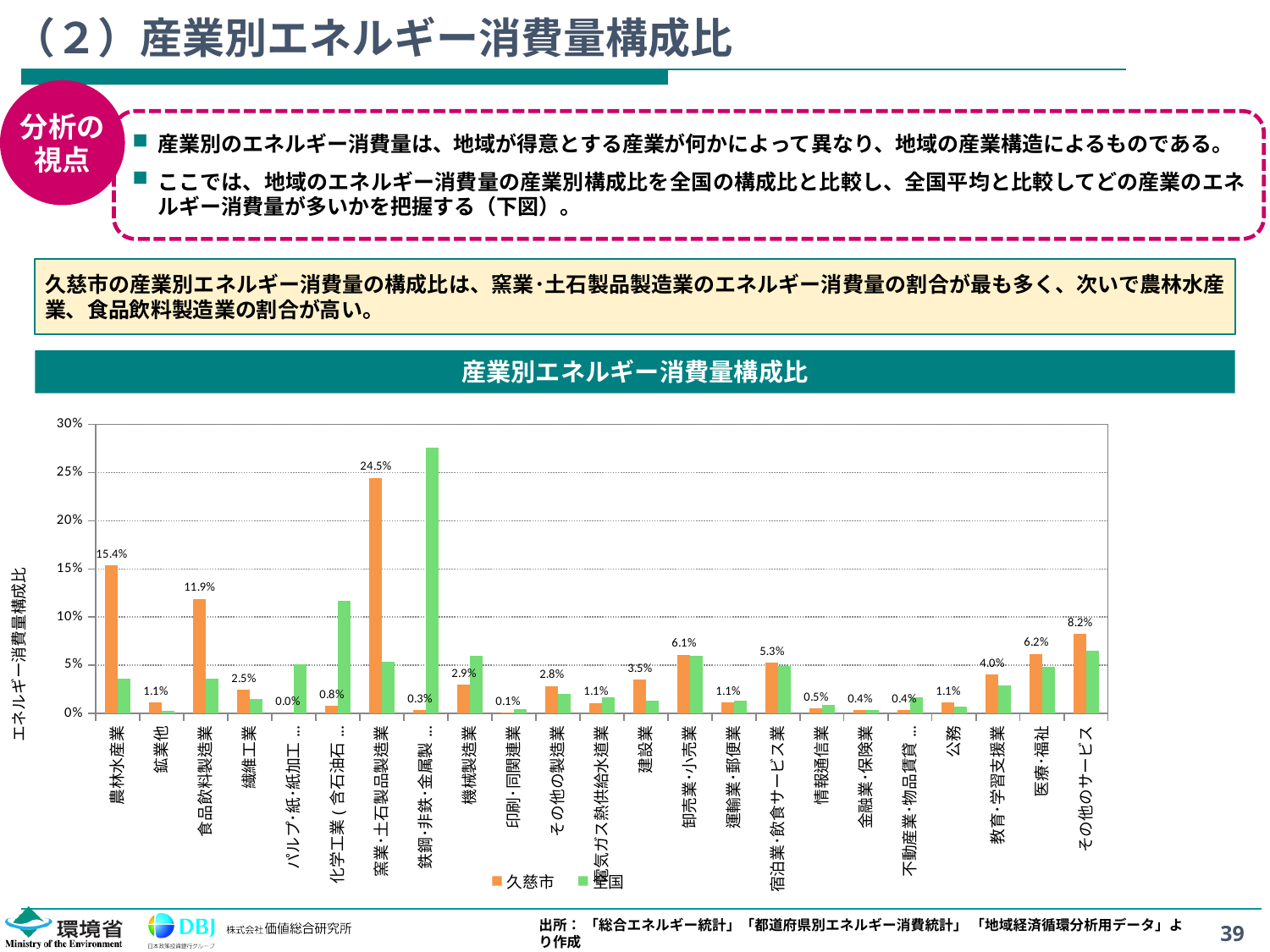
What kind of chart is shown on the slide? Bar chart What is the value for 久慈市 in the 窯業・土石製品製造業 category? 24.5% What is the difference between the 久慈市 values for 窯業・土石製品製造業 and 農林水産業? 9.1% What is the value for 久慈市 in the その他のサービス category? 8.2% What is the value for 久慈市 in the 食品飲料製造業 category? 11.9% What is the value for 久慈市 in the 農林水産業 category? 15.4% For 化学工業(含石油…, which series has the larger value, 久慈市 or 全国? 全国 Is the value for 全国 in the 鉄鋼・非鉄・金属製… category greater or less than 25%? greater Which category has the highest value for 全国? 鉄鋼・非鉄・金属製… How many industry categories are shown on the x axis? 23 Which category has the highest value for 久慈市? 窯業・土石製品製造業 How many series does the legend list? 2